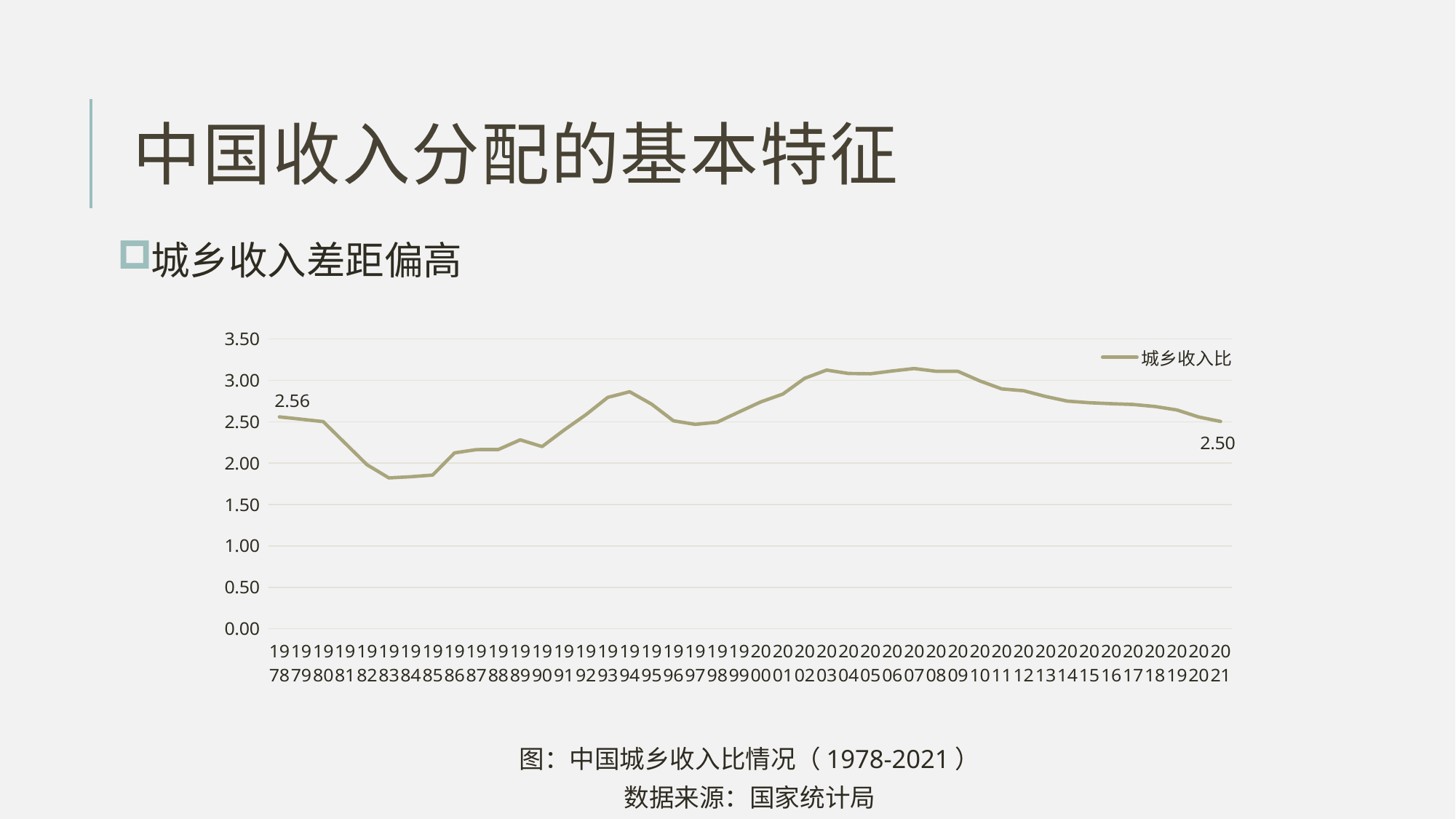
What kind of chart is shown on the slide? line chart Is the value for 2007 greater or less than 3.00? greater Is the value for 1983 greater or less than 2.00? less What is the difference between the 1978 value (2.56) and the 2021 value (2.50)? 0.06 Is the value for 1996 greater or less than 3.00? less Does the 城乡收入比 rise or fall from 2009 to 2021? fall How many series does the legend list? 1 What is the value of 城乡收入比 for 1978? 2.56 Which year has the larger 城乡收入比, 1978 or 2021? 1978 What is the value of 城乡收入比 for 2021? 2.50 How many years (data points) are plotted on the chart? 44